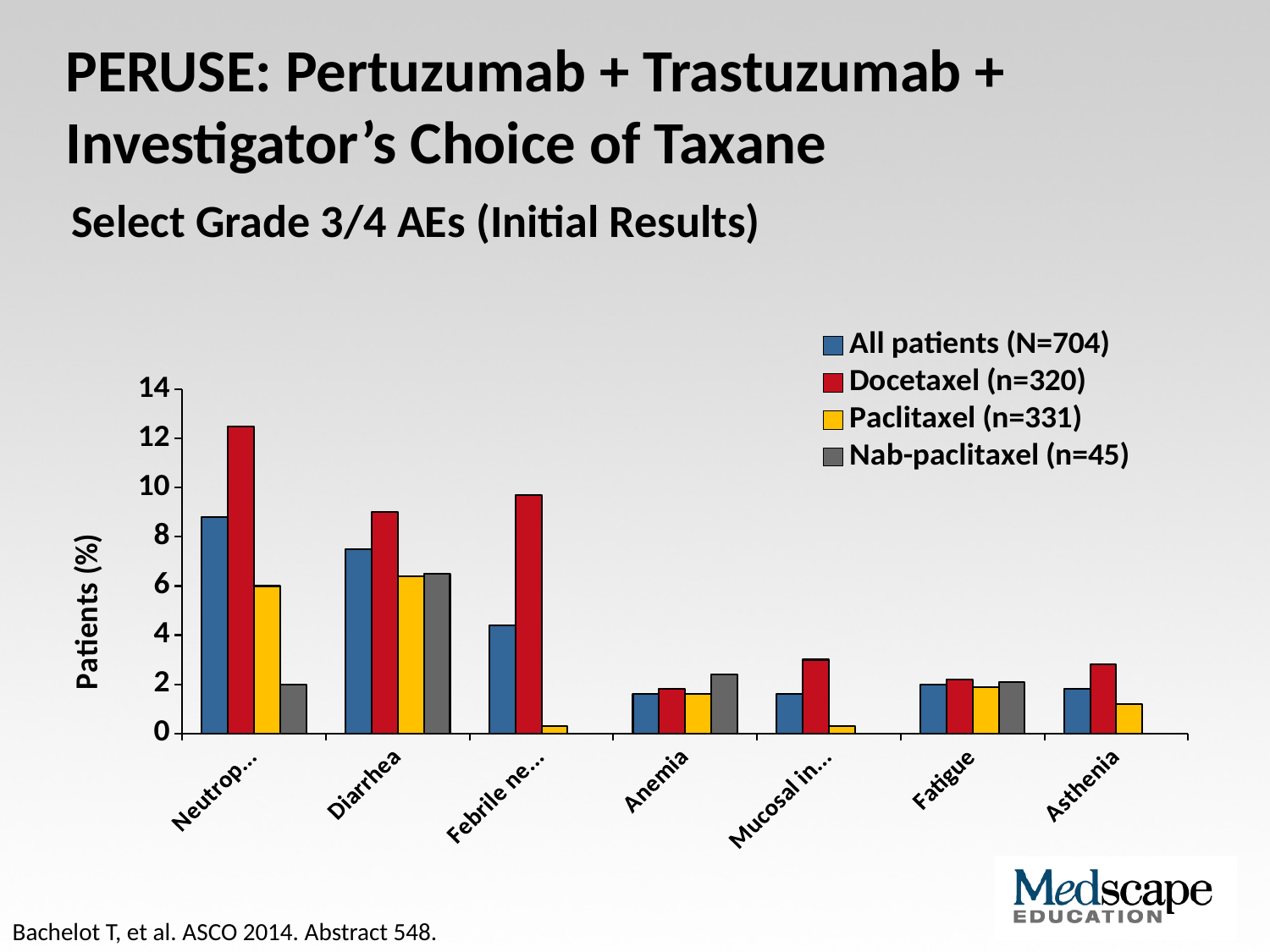
Which category has the highest Docetaxel bar? Neutrop... (Neutropenia) What kind of chart is shown on the slide? Bar chart Is the Docetaxel value for Febrile ne... greater or less than 8? greater What is the label on the y axis? Patients (%) How many series does the legend list? 4 For Febrile ne..., which is larger: the Docetaxel bar or the All patients bar? Docetaxel Is the Docetaxel value for the first category (Neutrop...) greater or less than 12? greater How many adverse event categories are shown along the x axis? 7 Is the Docetaxel value for Mucosal in... greater or less than 2? greater For Diarrhea, which series has the highest bar? Docetaxel (n=320) For Anemia, which is larger: the Nab-paclitaxel bar or the All patients bar? Nab-paclitaxel